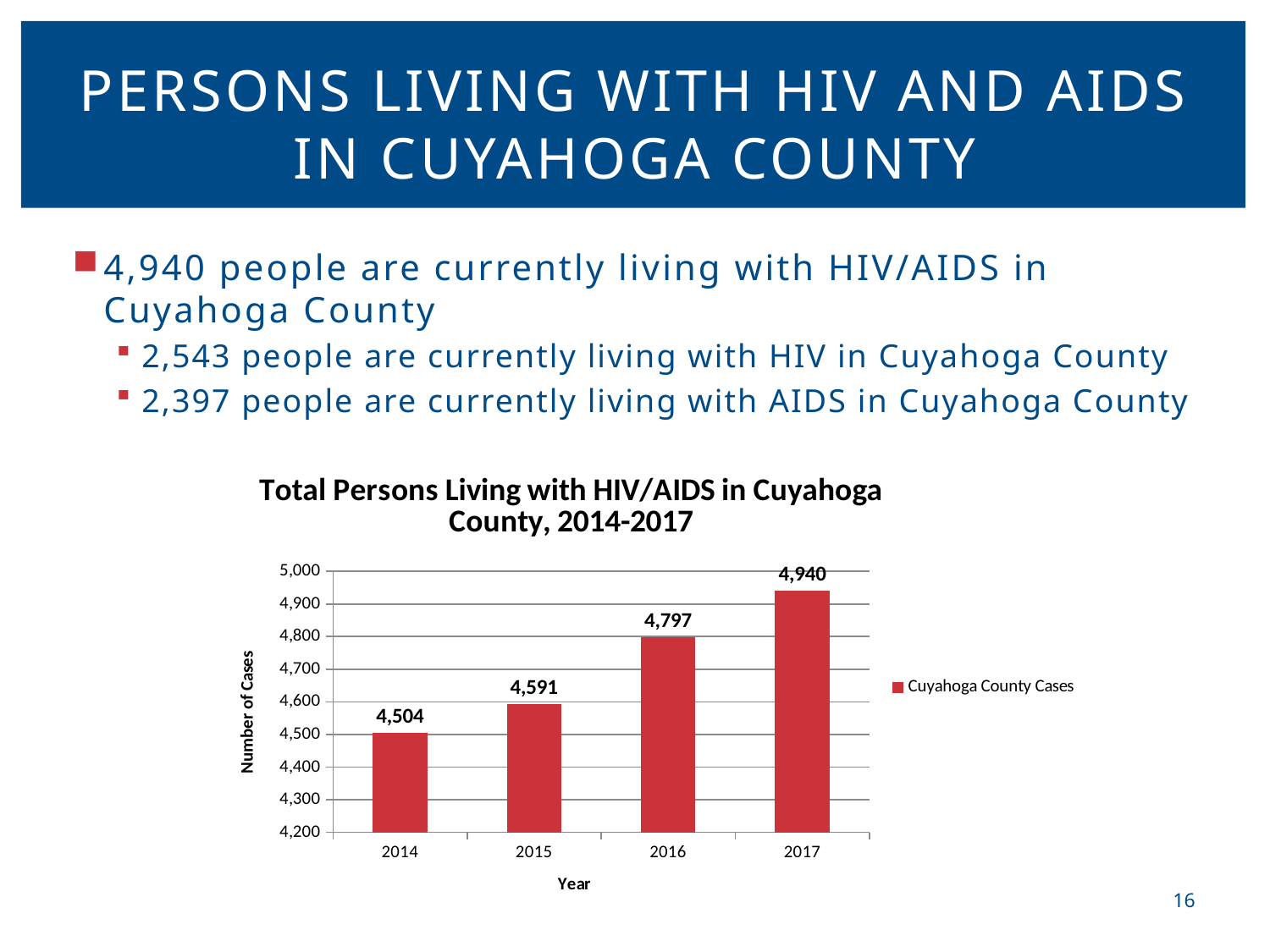
What is the difference between the values for 2016 and 2015? 206 Which year has the lowest number of cases? 2014 Do the values rise or fall from 2014 to 2017? rise What is the difference between the values for 2017 and 2014? 436 Which is larger, the value for 2015 or the value for 2016? 2016 What is the value for 2014? 4,504 Is the value for 2015 greater or less than 4,600? less What is the value for 2017? 4,940 Which year has the highest number of cases? 2017 What is the value for 2016? 4,797 How many years are shown on the x axis? 4 What kind of chart is shown? bar chart